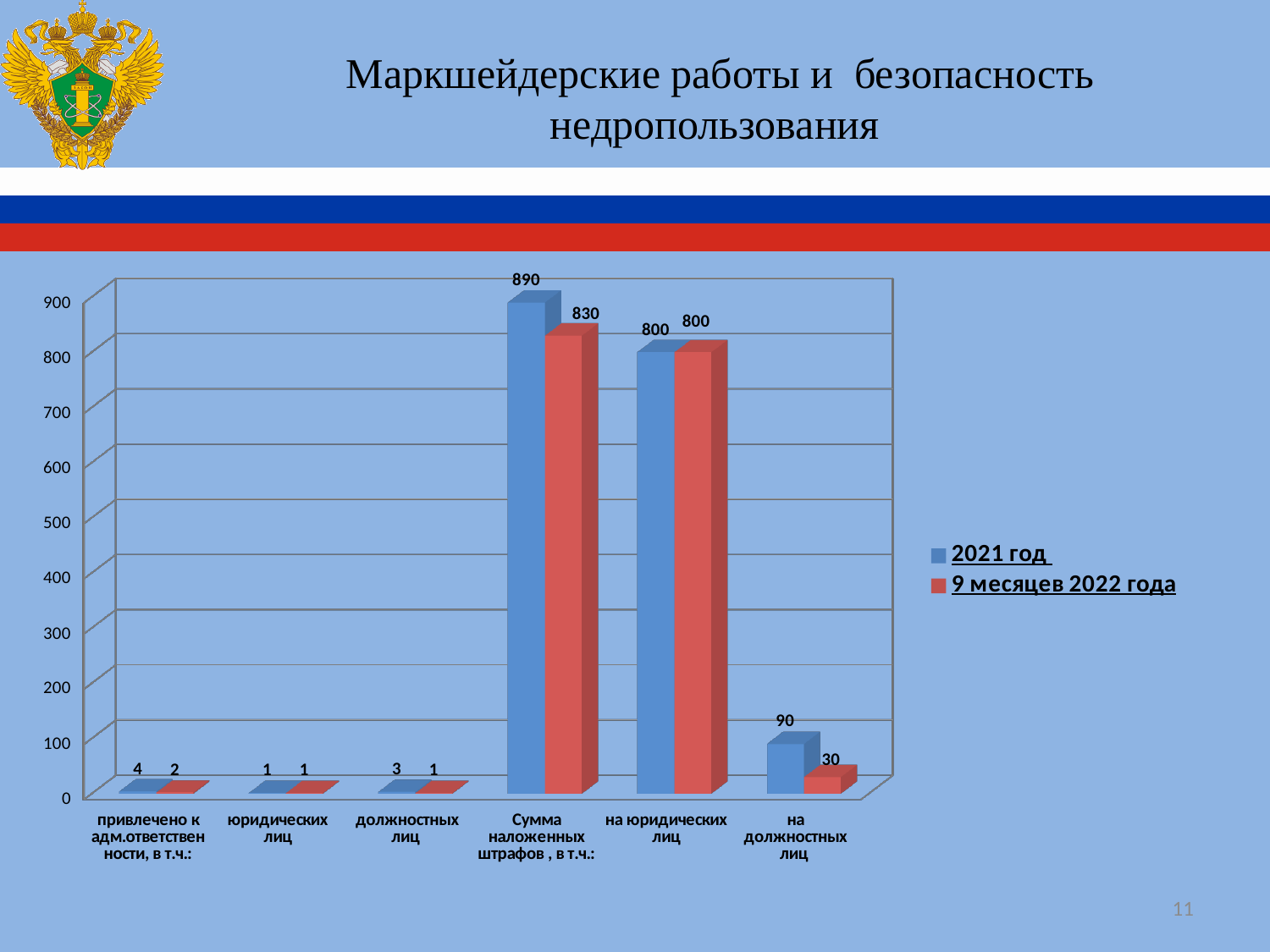
How many series does the legend list? 2 Which category has the highest value in the "2021 год" series? Сумма наложенных штрафов, в т.ч.: What is the value for "привлечено к адм.ответственности, в т.ч.:" in the "2021 год" series? 4 What is the difference between the "2021 год" and "9 месяцев 2022 года" values for "на должностных лиц"? 60 What is the value for "Сумма наложенных штрафов, в т.ч.:" in the "9 месяцев 2022 года" series? 830 What is the value for "на должностных лиц" in the "9 месяцев 2022 года" series? 30 How many categories are shown on the x axis? 6 What is the difference between the "2021 год" and "9 месяцев 2022 года" values for "Сумма наложенных штрафов, в т.ч.:"? 60 What is the value for "Сумма наложенных штрафов, в т.ч.:" in the "2021 год" series? 890 Which is larger for "должностных лиц": the "2021 год" value or the "9 месяцев 2022 года" value? 2021 год Which colour represents the "9 месяцев 2022 года" series? red What kind of chart is shown on the slide? bar chart